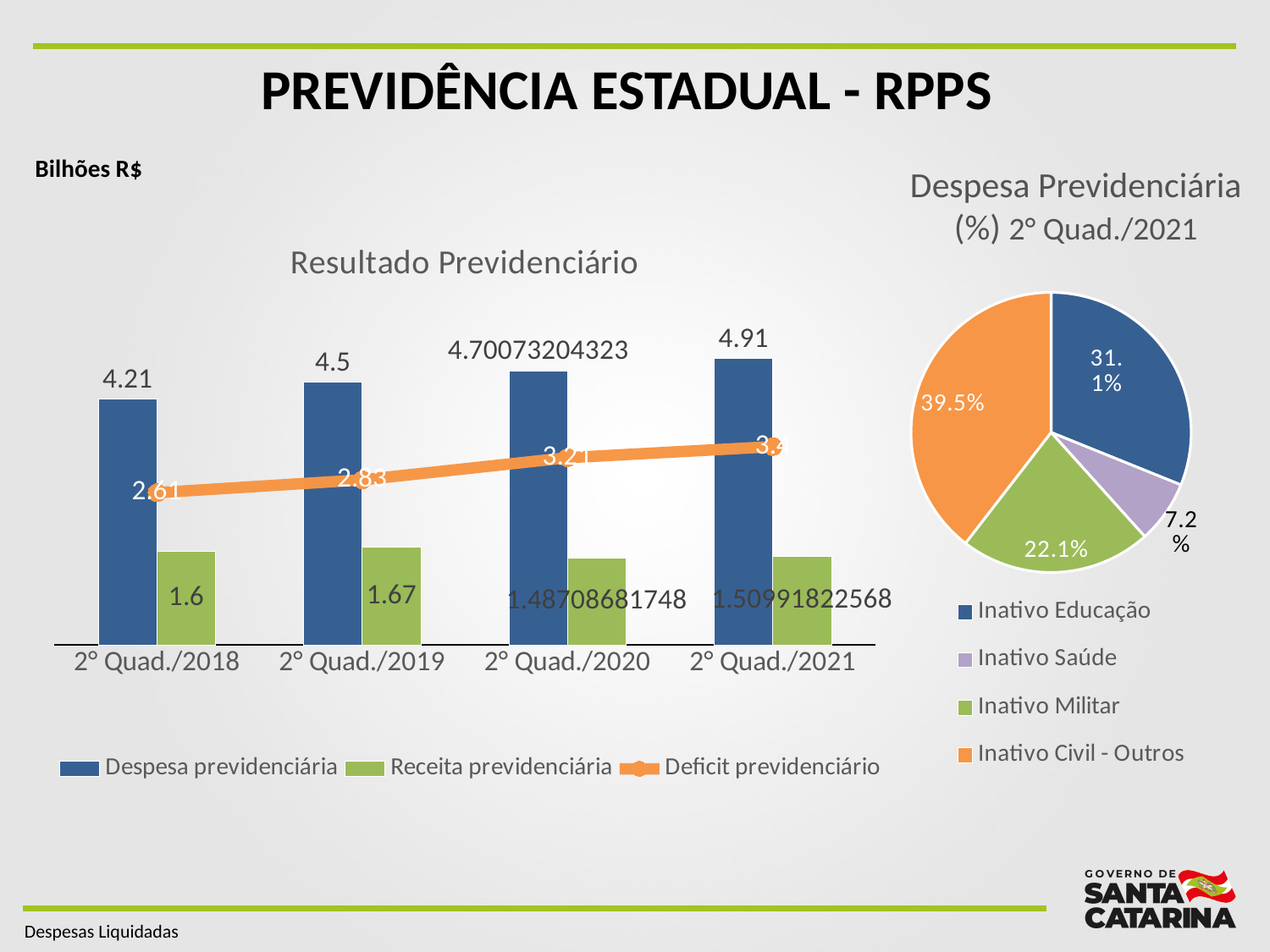
In the Resultado Previdenciário chart, what is the value of Receita previdenciária for 2° Quad./2019? 1.67 In the Resultado Previdenciário chart, which period has the highest Despesa previdenciária? 2° Quad./2021 In the Despesa Previdenciária (%) 2° Quad./2021 pie chart, what share does Inativo Militar have? 22.1% In the Resultado Previdenciário chart, which is larger: Receita previdenciária in 2° Quad./2018 or in 2° Quad./2019? 2° Quad./2019 How many series does the legend of the Resultado Previdenciário chart list? 3 In the Resultado Previdenciário chart, what is the difference between Despesa previdenciária in 2° Quad./2019 and 2° Quad./2018? 0.29 In the Resultado Previdenciário chart, does Despesa previdenciária rise or fall from 2° Quad./2018 to 2° Quad./2021? rise In the Despesa Previdenciária (%) 2° Quad./2021 pie chart, which category has the largest slice? Inativo Civil - Outros In the Resultado Previdenciário chart, what is the value of Despesa previdenciária for 2° Quad./2021? 4.91 In the Resultado Previdenciário chart, what is the Deficit previdenciário for 2° Quad./2020? 3.21 What kind of chart is the Despesa Previdenciária (%) 2° Quad./2021 chart? pie chart How many periods are shown on the x axis of the Resultado Previdenciário chart? 4